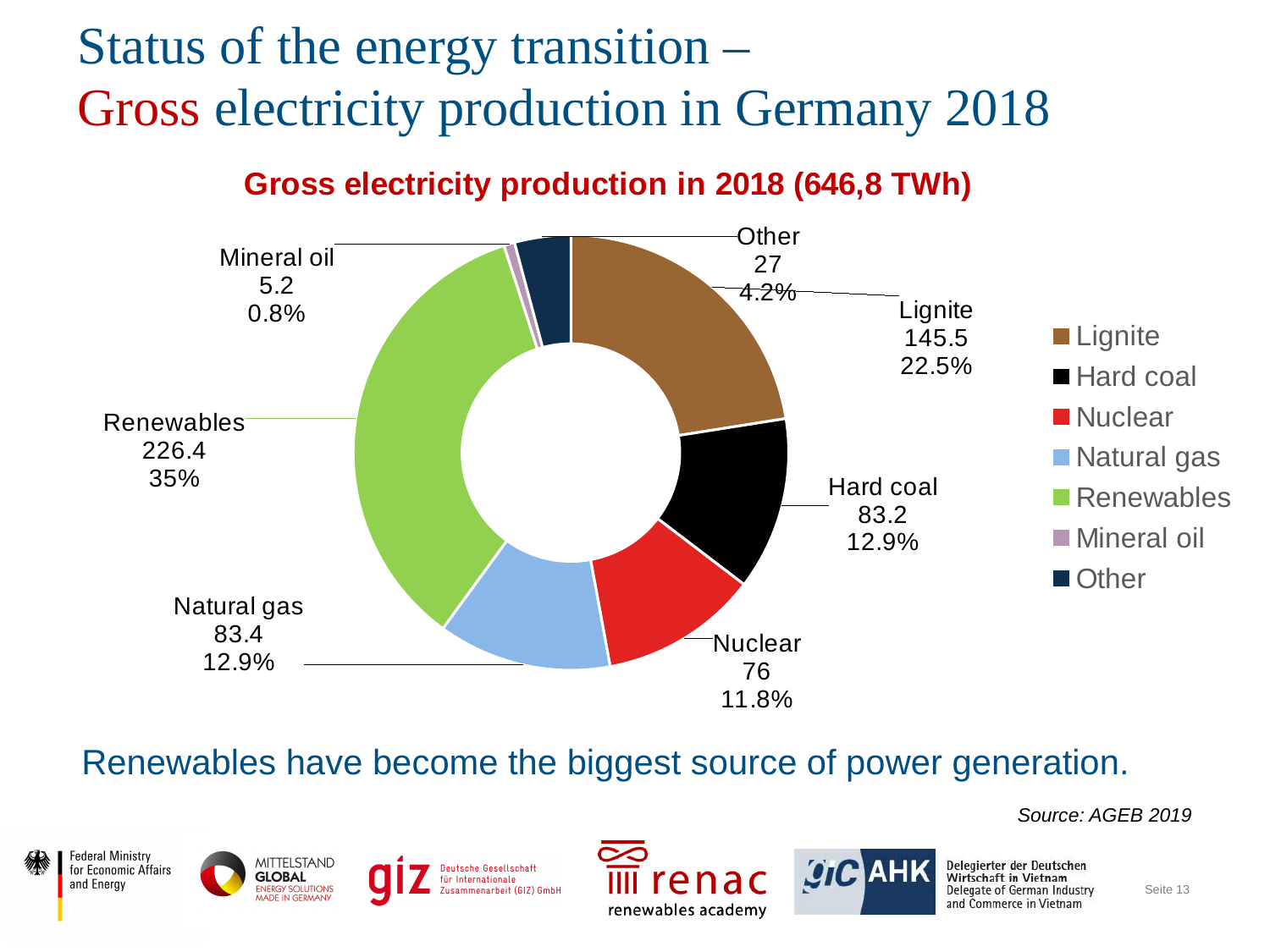
How many categories does the chart show? 7 What is the value shown for Nuclear? 76 Which category has the largest share of gross electricity production in 2018? Renewables What percentage share does Lignite have in the chart? 22.5% What is the value shown for Other? 27 What total gross electricity production is given in the chart title? 646,8 TWh Which is larger, the value for Lignite or the value for Hard coal? Lignite Which category has the smallest share in the chart? Mineral oil What percentage share does Renewables have in the chart? 35% What is the value for Renewables in the Gross electricity production in 2018 chart? 226.4 What kind of chart is shown on the slide? doughnut chart What is the difference between the values for Renewables and Lignite? 80.9